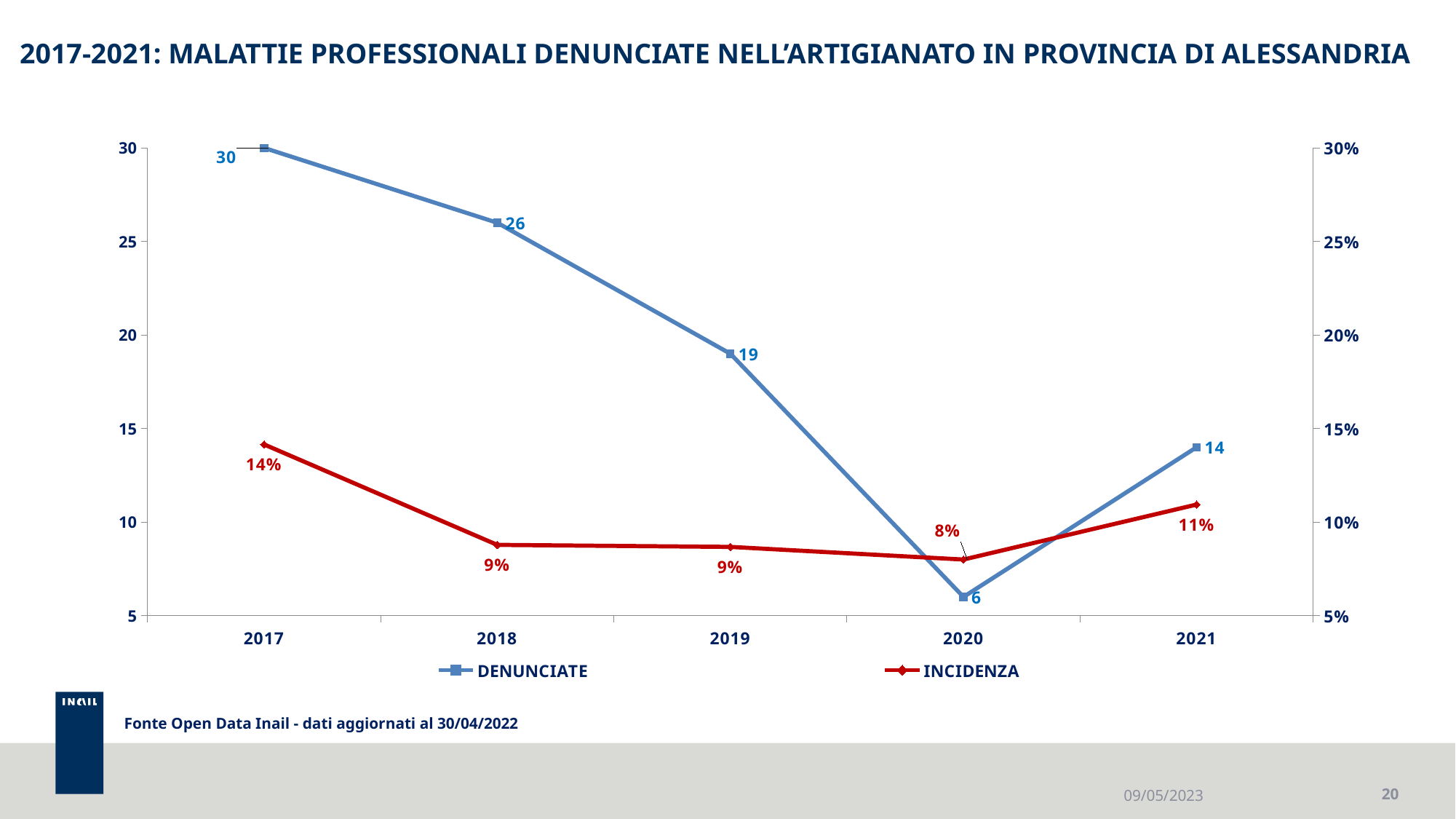
What is the difference between the DENUNCIATE values for 2017 and 2018? 4 How many years are shown on the x axis? 5 What is the source note printed below the chart? Fonte Open Data Inail - dati aggiornati al 30/04/2022 In which year is the DENUNCIATE series highest? 2017 Which is larger, the DENUNCIATE value for 2021 or for 2020? 2021 How many series does the legend list? 2 What is the DENUNCIATE value for 2020? 6 What is the DENUNCIATE value for 2019? 19 What is the INCIDENZA value for 2021? 11% In which year is the INCIDENZA series lowest? 2020 What kind of chart is shown on the slide? line chart Does the DENUNCIATE series rise or fall from 2017 to 2020? fall